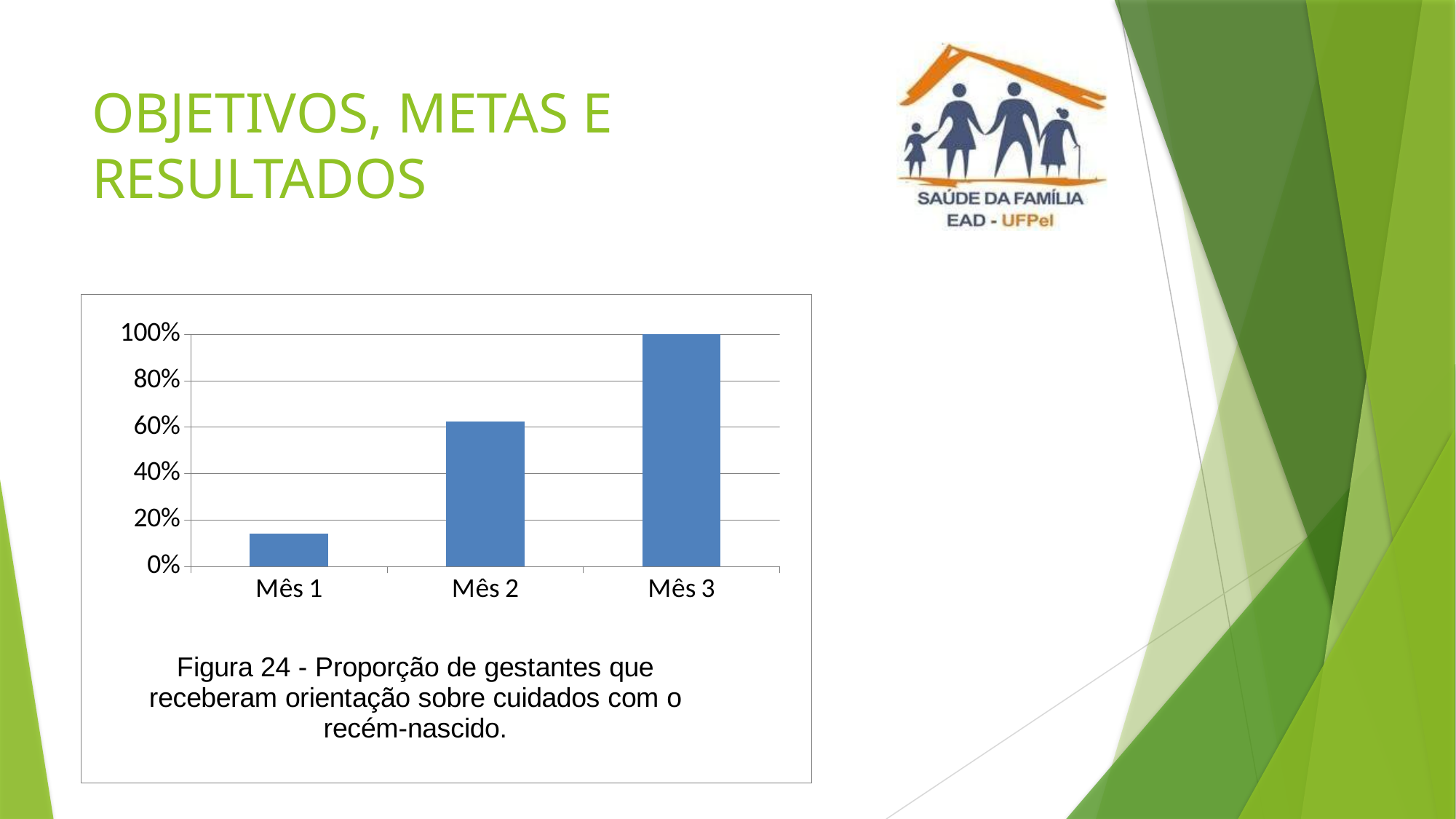
Which is larger, the value for Mês 1 or the value for Mês 2? Mês 2 What type of chart is shown on the slide? bar chart Which month has the lowest value? Mês 1 Which month has the highest value? Mês 3 Is the value for Mês 1 greater or less than 20%? less Do the values rise or fall from Mês 1 to Mês 3? rise What is the figure number given in the caption below the chart? Figura 24 How many categories are shown on the x axis of the chart? 3 Is the value for Mês 2 greater or less than 80%? less What is the highest value shown on the y axis of the chart? 100% Is the value for Mês 2 greater or less than 40%? greater What is the value for Mês 3? 100%